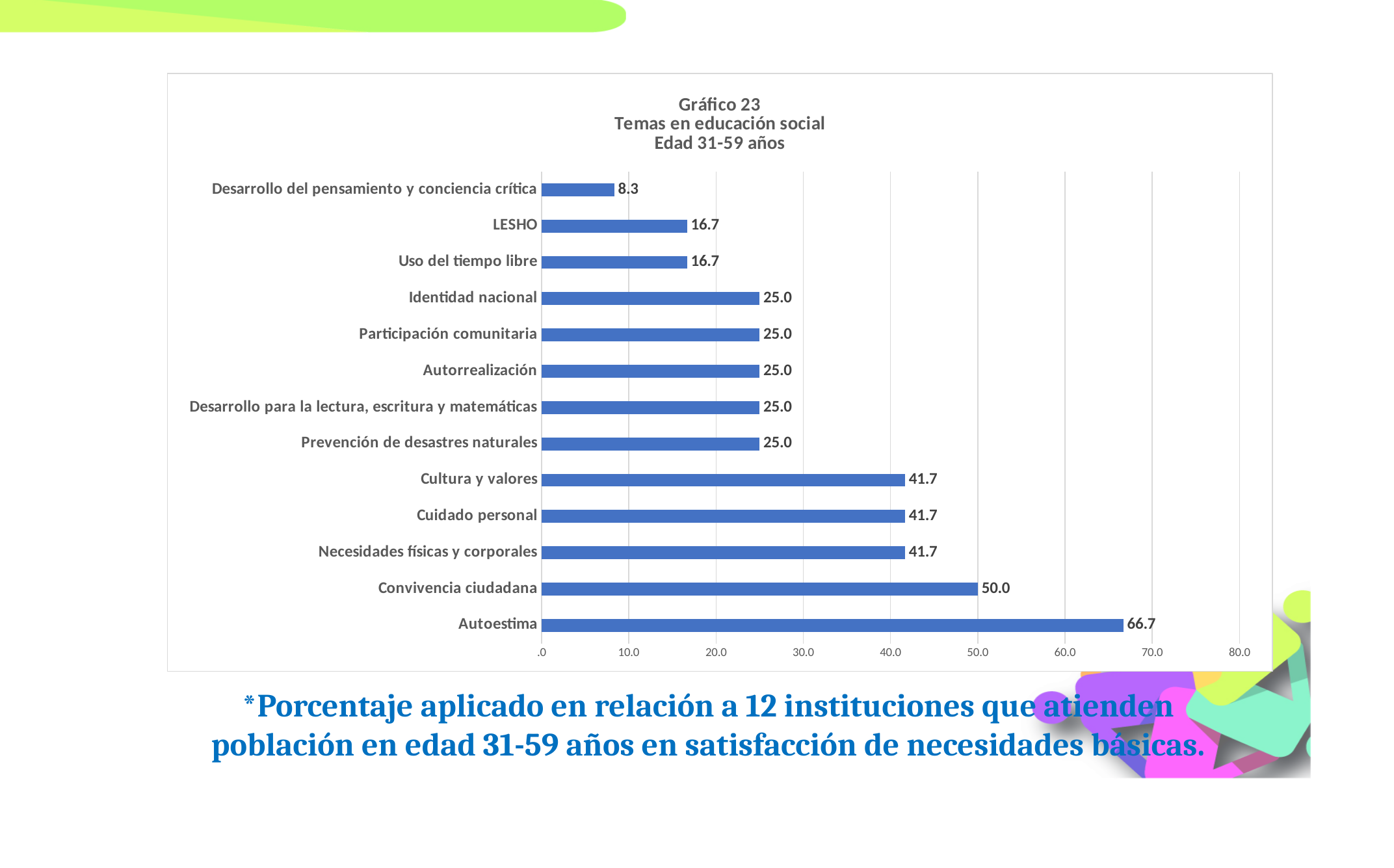
What is the value for LESHO? 16.7 Is the value for Cuidado personal greater or less than 40.0? greater What is the difference between the values for Autoestima and Convivencia ciudadana? 16.7 What is the value for Autoestima? 66.7 What kind of chart is shown on the slide? Bar chart What is the value for Desarrollo del pensamiento y conciencia crítica? 8.3 How many categories are shown in the chart? 13 Which category has the highest value? Autoestima What is the title of the chart? Gráfico 23 Temas en educación social Edad 31-59 años What is the value for Convivencia ciudadana? 50.0 Which category has the lowest value? Desarrollo del pensamiento y conciencia crítica Which is larger, the value for Cultura y valores or the value for Identidad nacional? Cultura y valores